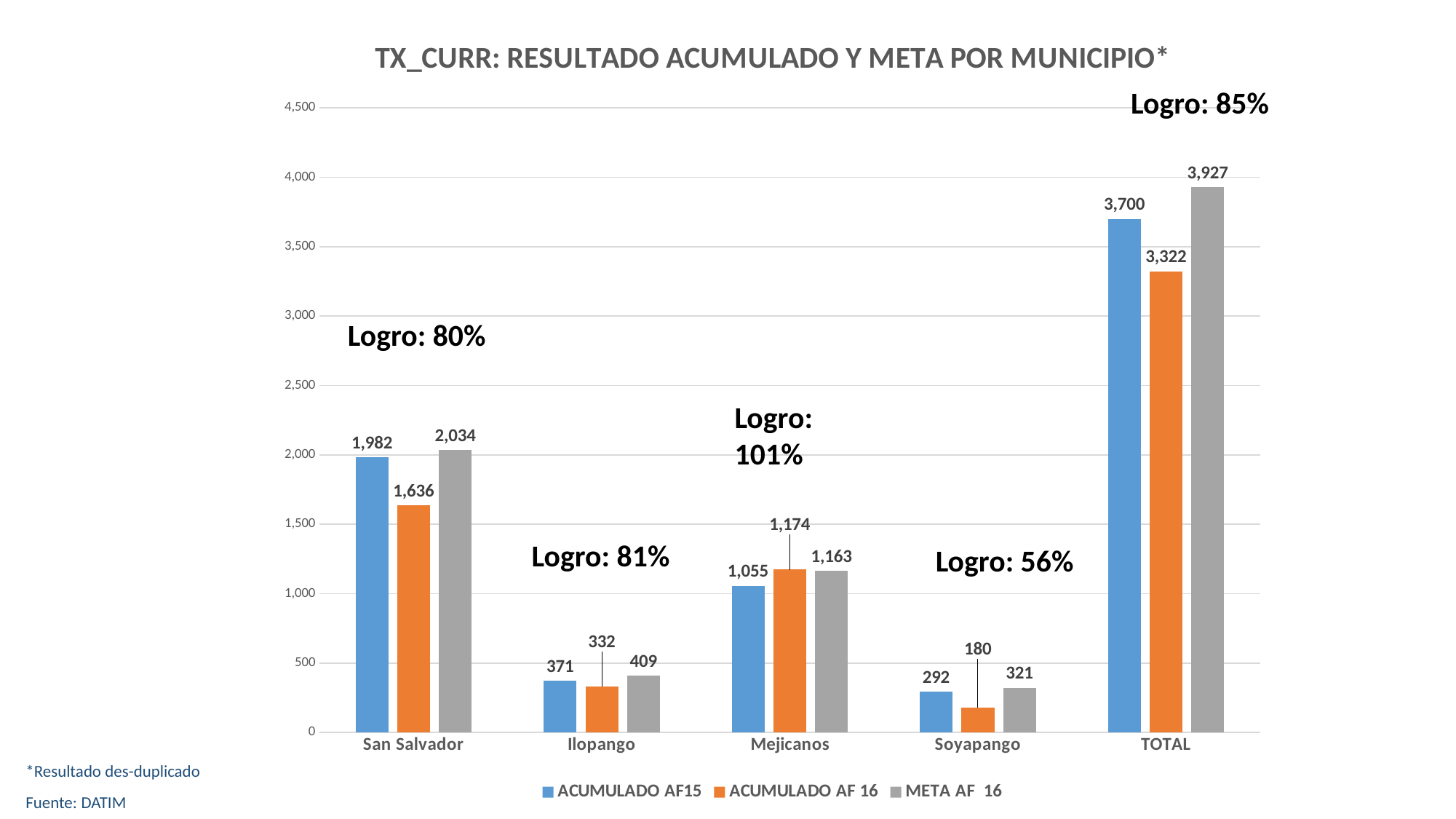
Which is larger for Mejicanos: ACUMULADO AF 16 or META AF 16? ACUMULADO AF 16 What is the Logro percentage shown for Soyapango? 56% How many categories are shown on the x axis? 5 Is the ACUMULADO AF15 value for Ilopango greater or less than 500? less What is the difference between the META AF 16 and ACUMULADO AF 16 values for TOTAL? 605 What kind of chart is shown on the slide? bar chart How many series does the legend list? 3 What is the ACUMULADO AF 16 value for San Salvador? 1,636 What is the ACUMULADO AF15 value for Mejicanos? 1,055 What is the META AF 16 value for Soyapango? 321 Which municipality (excluding TOTAL) has the highest META AF 16 value? San Salvador Which municipality (excluding TOTAL) has the lowest ACUMULADO AF 16 value? Soyapango